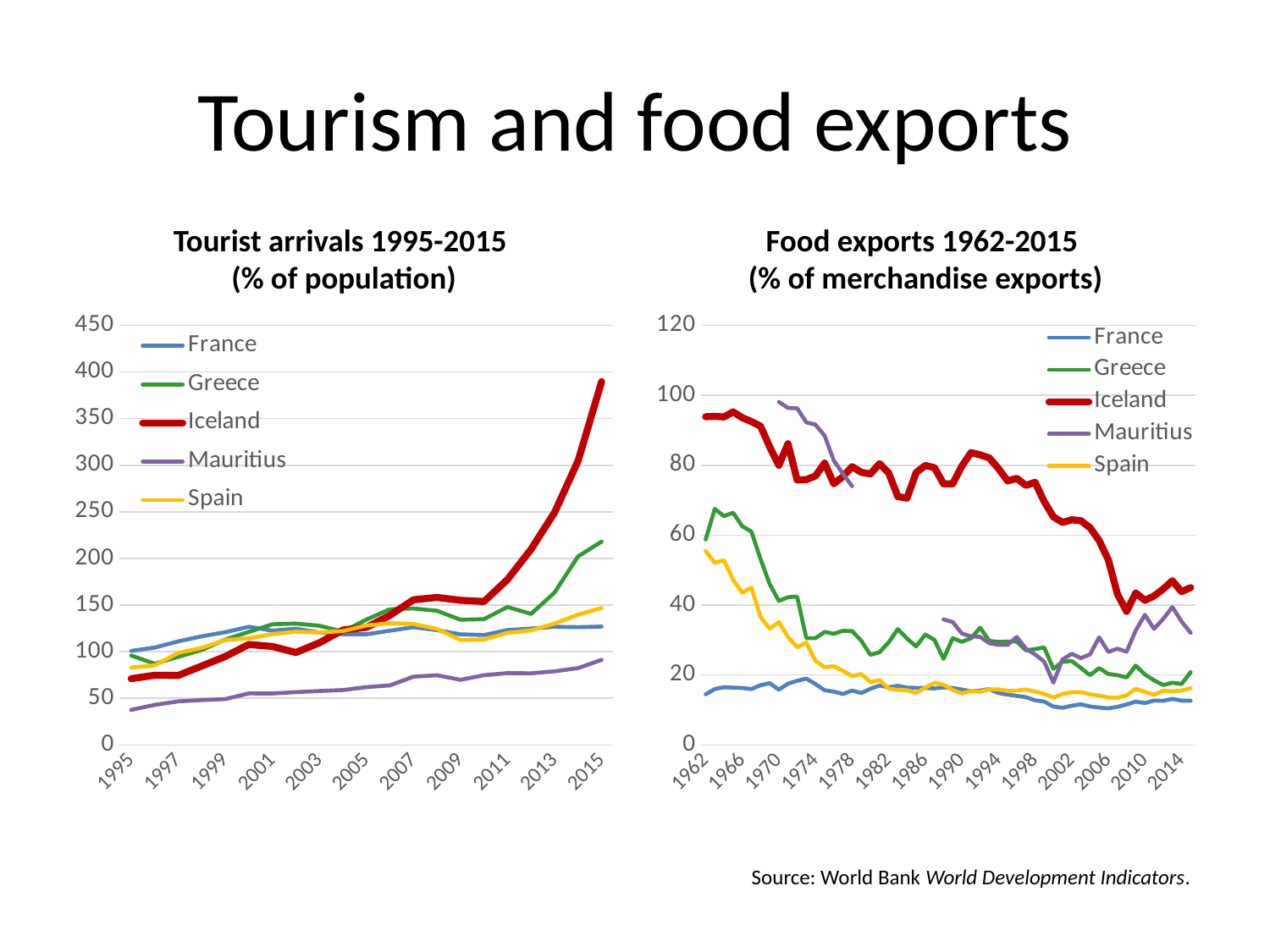
In the 'Tourist arrivals 1995-2015' chart, which country has the lowest value in 2015? Mauritius In the 'Tourist arrivals 1995-2015' chart, is the value for Iceland in 2015 greater or less than 350? greater How many series does the legend of the 'Food exports 1962-2015' chart list? 5 In the 'Tourist arrivals 1995-2015' chart, does the Iceland line rise or fall overall from 1995 to 2015? rise In the 'Tourist arrivals 1995-2015' chart, which country has the highest value in 2015? Iceland In the 'Food exports 1962-2015' chart, does the Iceland line rise or fall overall from 1962 to 2015? fall In the 'Food exports 1962-2015' chart, which country has the highest value in 1962? Iceland What colour is the Iceland line in the 'Food exports 1962-2015' chart? red What kind of chart is the 'Tourist arrivals 1995-2015' chart? line chart In the 'Tourist arrivals 1995-2015' chart, is the value for Mauritius in 1995 greater or less than 50? less In the 'Food exports 1962-2015' chart, which is larger in 2014, the value for Iceland or the value for France? Iceland In the 'Food exports 1962-2015' chart, is the value for Iceland in 1962 greater or less than 80? greater